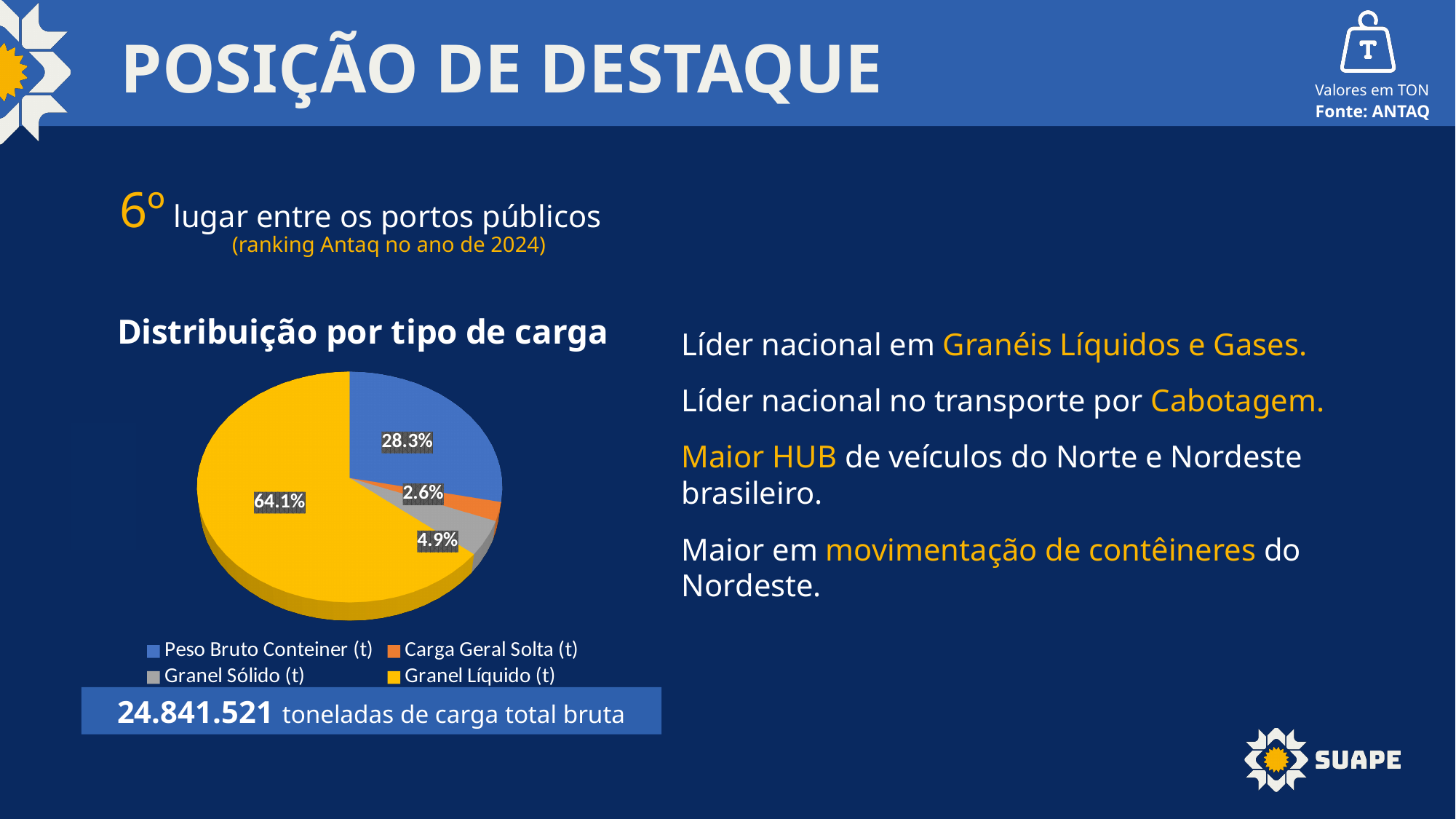
Which is larger, the share for Granel Sólido (t) or the share for Carga Geral Solta (t)? Granel Sólido (t) Which cargo type has the largest slice of the pie? Granel Líquido (t) Which cargo type has the smallest slice of the pie? Carga Geral Solta (t) What share of the pie does Granel Líquido (t) represent? 64.1% How many slices does the pie chart have? 4 What is the title of the pie chart? Distribuição por tipo de carga What colour is the Granel Líquido (t) slice in the pie chart? Yellow What share of the pie does Peso Bruto Conteiner (t) represent? 28.3% What is the difference in percentage points between Granel Líquido (t) and Peso Bruto Conteiner (t)? 35.8 What share of the pie does Carga Geral Solta (t) represent? 2.6% What kind of chart is shown under "Distribuição por tipo de carga"? Pie chart